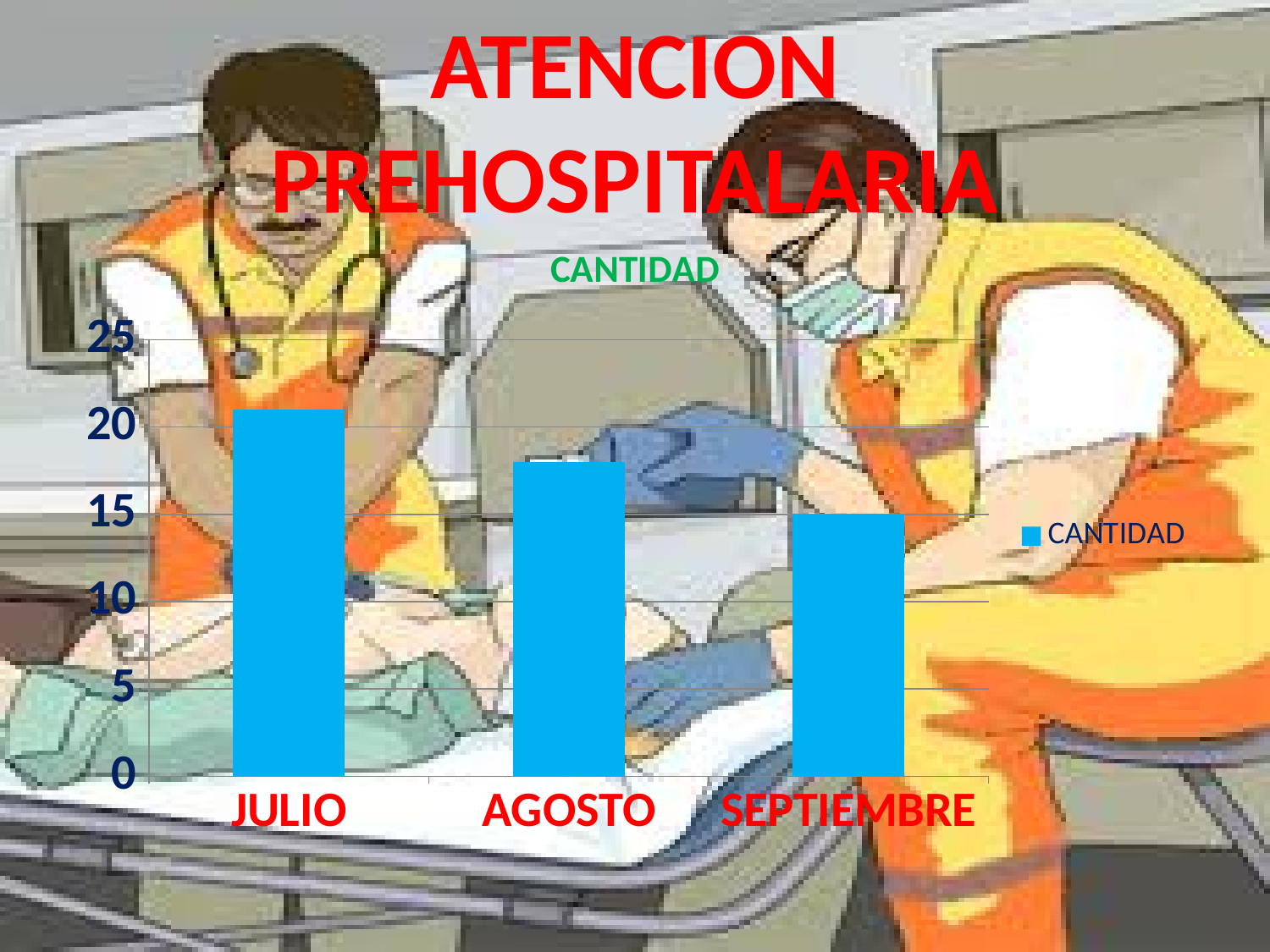
Is the value for SEPTIEMBRE greater or less than 20? less What kind of chart is shown on the slide? bar chart What is the title of the chart? CANTIDAD How many series does the chart legend list? 1 Which month has the highest value in the chart? JULIO Is the value for AGOSTO greater or less than 20? less Which is larger, the value for JULIO or the value for AGOSTO? JULIO Do the values rise or fall from JULIO to SEPTIEMBRE? fall Is the value for JULIO greater or less than 20? greater Which month has the lowest value in the chart? SEPTIEMBRE How many categories are shown on the x axis of the chart? 3 What series name appears in the chart legend? CANTIDAD